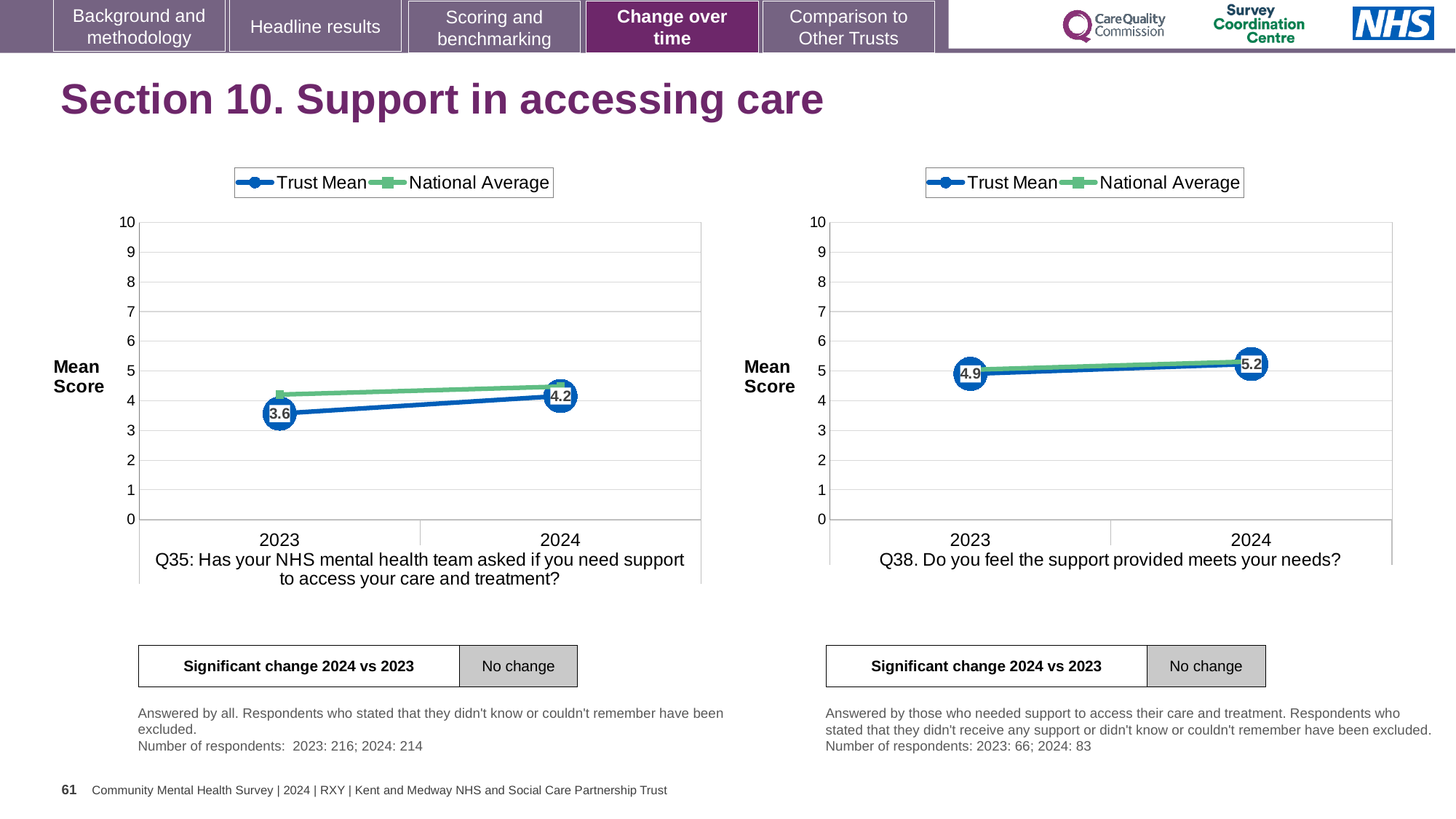
In the Q35 chart on the left, by how much did the Trust Mean change from 2023 to 2024? 0.6 In the Q35 chart on the left, what is the Trust Mean score for 2023? 3.6 In the Q38 chart on the right, what is the difference between the Trust Mean in 2024 and in 2023? 0.3 In the Q38 chart on the right, what is the Trust Mean score for 2024? 5.2 In the Q35 chart on the left, what is the Trust Mean score for 2024? 4.2 In the Q38 chart on the right, which year has the higher Trust Mean, 2023 or 2024? 2024 In the Q35 chart on the left, is the National Average for 2023 greater or less than 3? greater How many series does the legend of the Q38 chart on the right list? 2 What kind of chart is the Q35 chart on the left? line chart How many years are plotted on the x axis of the Q35 chart on the left? 2 In the Q35 chart on the left, does the Trust Mean rise or fall from 2023 to 2024? rise In the Q38 chart on the right, what is the Trust Mean score for 2023? 4.9